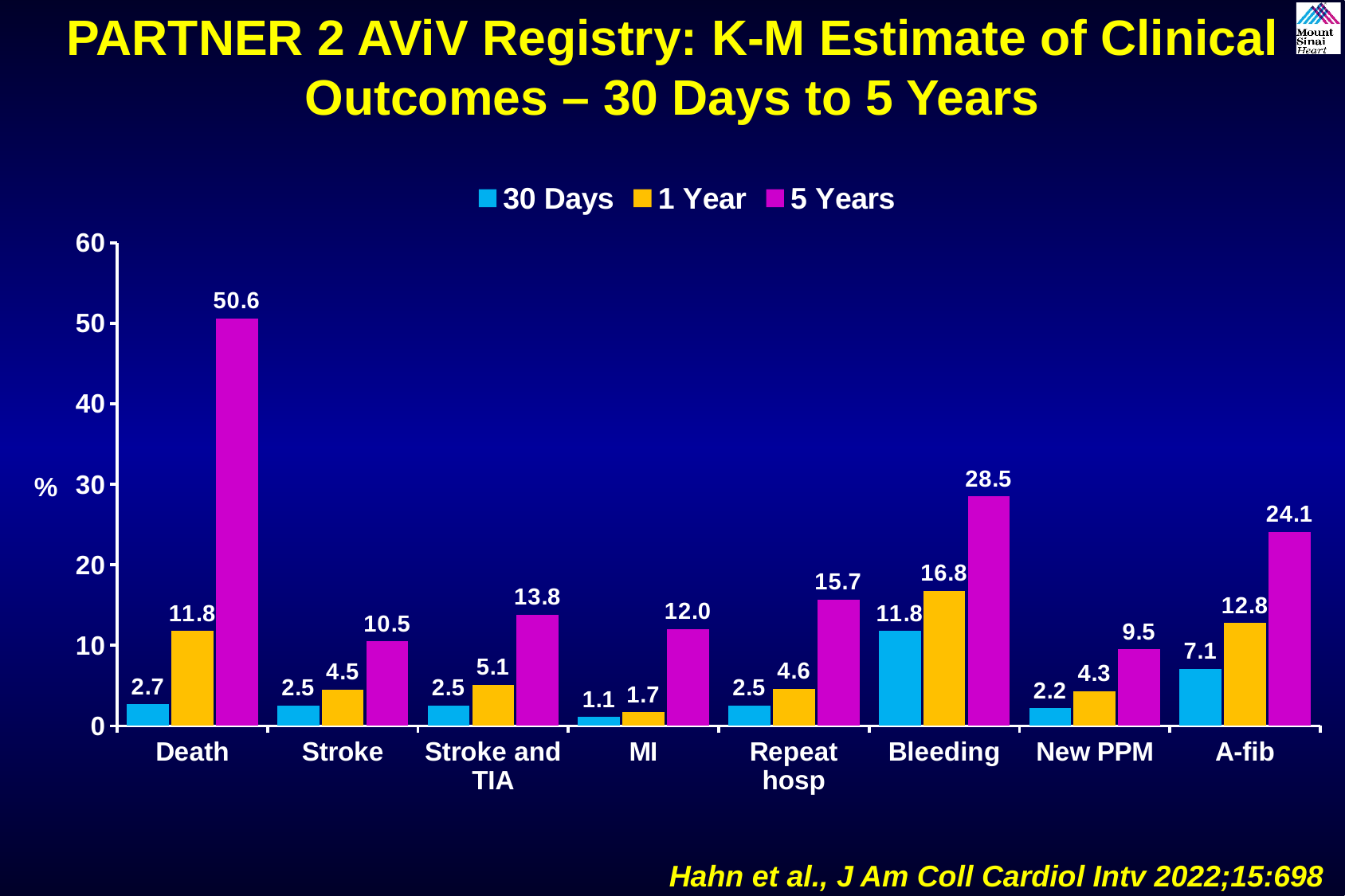
What is the 5 Years value for Death? 50.6 How many outcome categories are shown on the x axis? 8 Which category has the highest 5 Years value? Death Which colour represents the 5 Years series in the legend? Magenta How many series does the legend list? 3 What kind of chart is shown on the slide? Bar chart Which is larger, the 5 Years value for A-fib or the 5 Years value for Bleeding? Bleeding Is the 5 Years value for Death greater or less than 40? greater What is the 30 Days value for A-fib? 7.1 Which category has the lowest 30 Days value? MI What is the 1 Year value for Bleeding? 16.8 What is the difference between the 5 Years and 1 Year values for Bleeding? 11.7